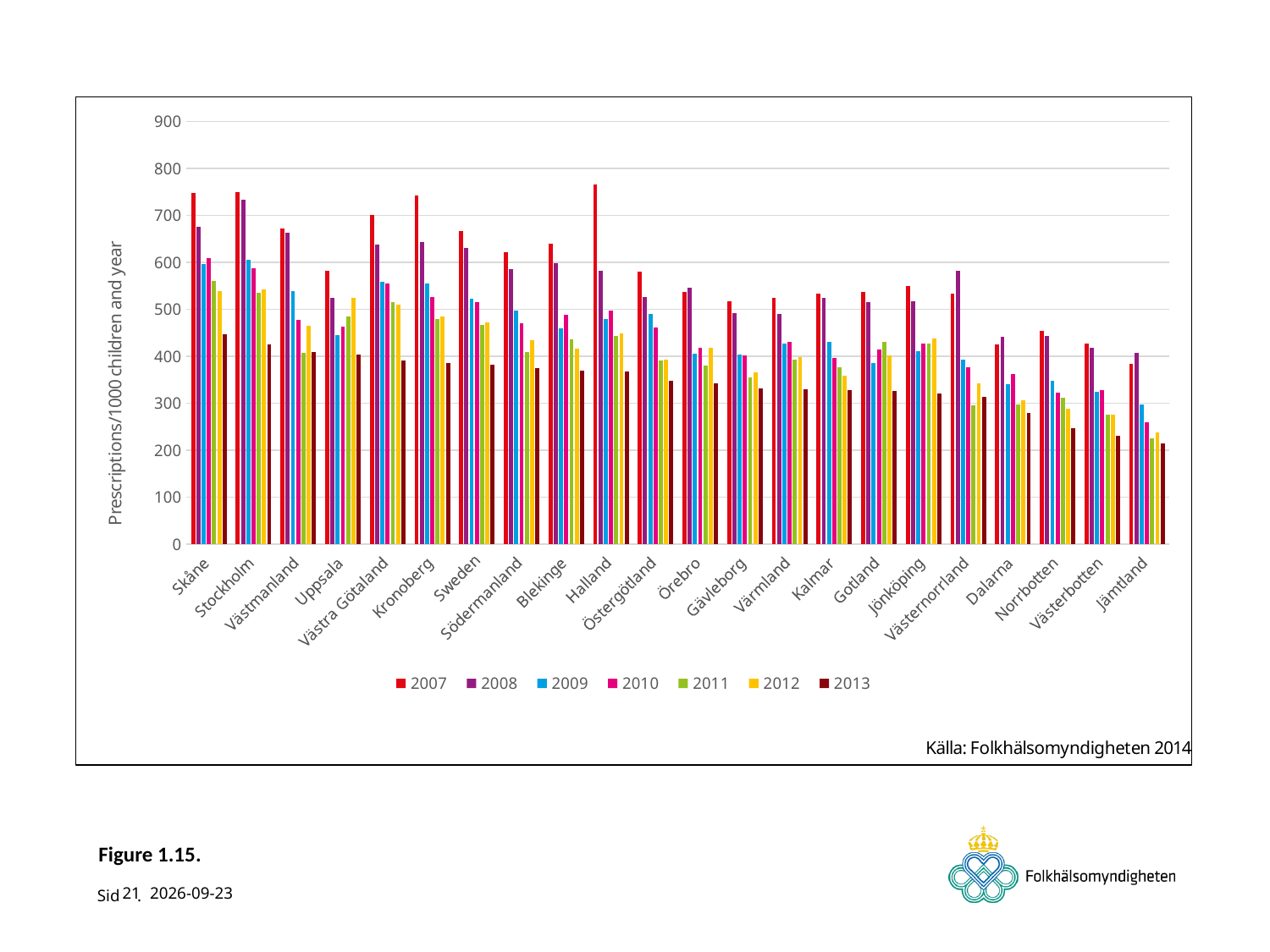
Which region has the lowest 2007 value? Jämtland How many series does the legend list? 7 What kind of chart is shown on the slide? bar chart Do the 2007 values generally rise or fall moving from left to right along the x axis? fall Is the 2013 value for Jämtland greater or less than 300? less Is the 2007 value for Halland greater or less than 700? greater What source is cited for the chart? Källa: Folkhälsomyndigheten 2014 How many categories (regions) are shown along the x axis? 22 Is the 2007 value for Uppsala greater or less than 500? greater What is the label on the y axis? Prescriptions/1000 children and year Which is larger for Skåne: the 2007 value or the 2013 value? 2007